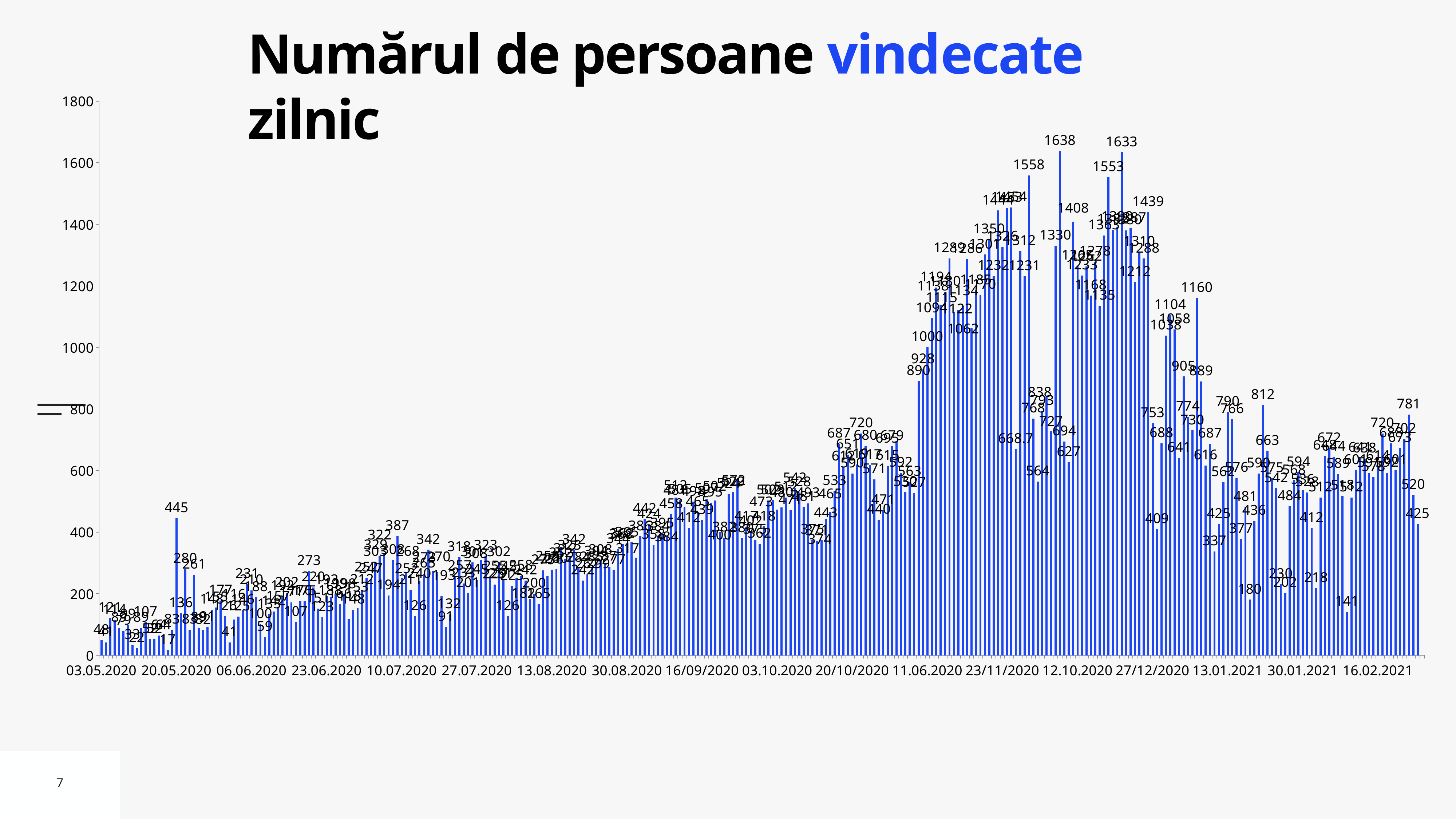
What is the title of the chart? Numărul de persoane vindecate zilnic What is the highest daily value shown in the chart? 1638 What is the value of the last (rightmost) bar in the chart? 425 What kind of chart is shown on the slide? bar chart What is the highest tick value shown on the vertical axis? 1800 What is the difference between the two highest labelled values, 1638 and 1633? 5 Is the value of the rightmost bar greater or less than 400? greater Overall, do the values rise or fall from the start of the chart (May 2020) to the peak in late 2020? rise Is the highest bar in the chart greater or less than 1600? greater What is the difference between the highest value 1638 and the value 1558? 80 What is the second highest labelled value in the chart? 1633 What is the first date label shown on the horizontal axis? 03.05.2020